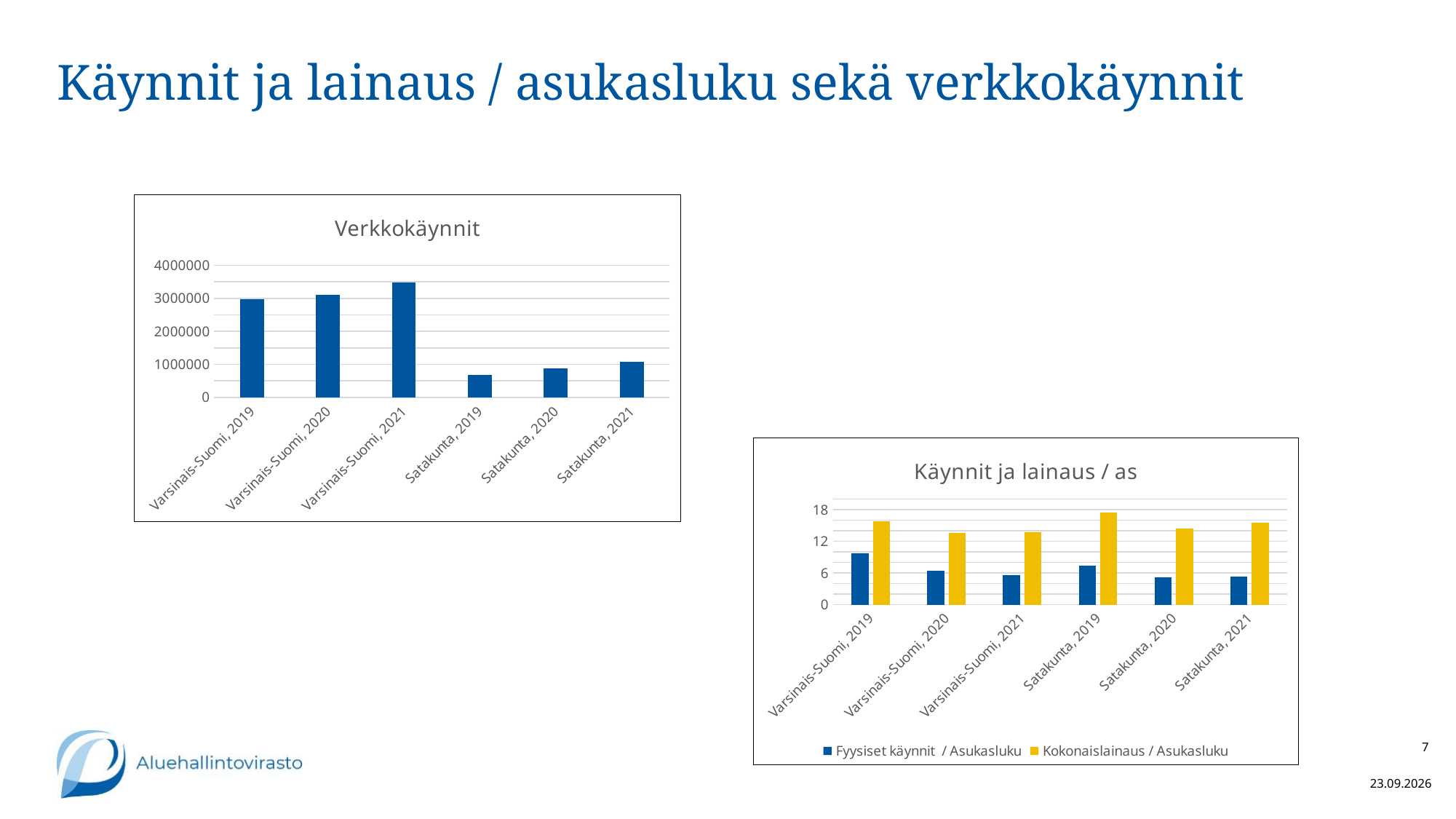
In the Verkkokäynnit chart, which category has the lowest value? Satakunta, 2019 In the Verkkokäynnit chart, how many categories are plotted? 6 In the Verkkokäynnit chart, is the value for Varsinais-Suomi, 2019 greater or less than 2000000? greater In the Käynnit ja lainaus / as chart, which category has the highest Fyysiset käynnit / Asukasluku value? Varsinais-Suomi, 2019 In the Käynnit ja lainaus / as chart, which series is shown in yellow? Kokonaislainaus / Asukasluku In the Verkkokäynnit chart, do the values for Satakunta rise or fall from 2019 to 2021? rise In the Käynnit ja lainaus / as chart, is the Fyysiset käynnit / Asukasluku value for Varsinais-Suomi, 2019 greater or less than 6? greater In the Verkkokäynnit chart, which category has the highest value? Varsinais-Suomi, 2021 In the Käynnit ja lainaus / as chart, how many series does the legend list? 2 In the Verkkokäynnit chart, what kind of chart is shown? bar chart In the Käynnit ja lainaus / as chart, which category has the highest Kokonaislainaus / Asukasluku value? Satakunta, 2019 In the Verkkokäynnit chart, is the value for Satakunta, 2021 greater or less than 1000000? greater